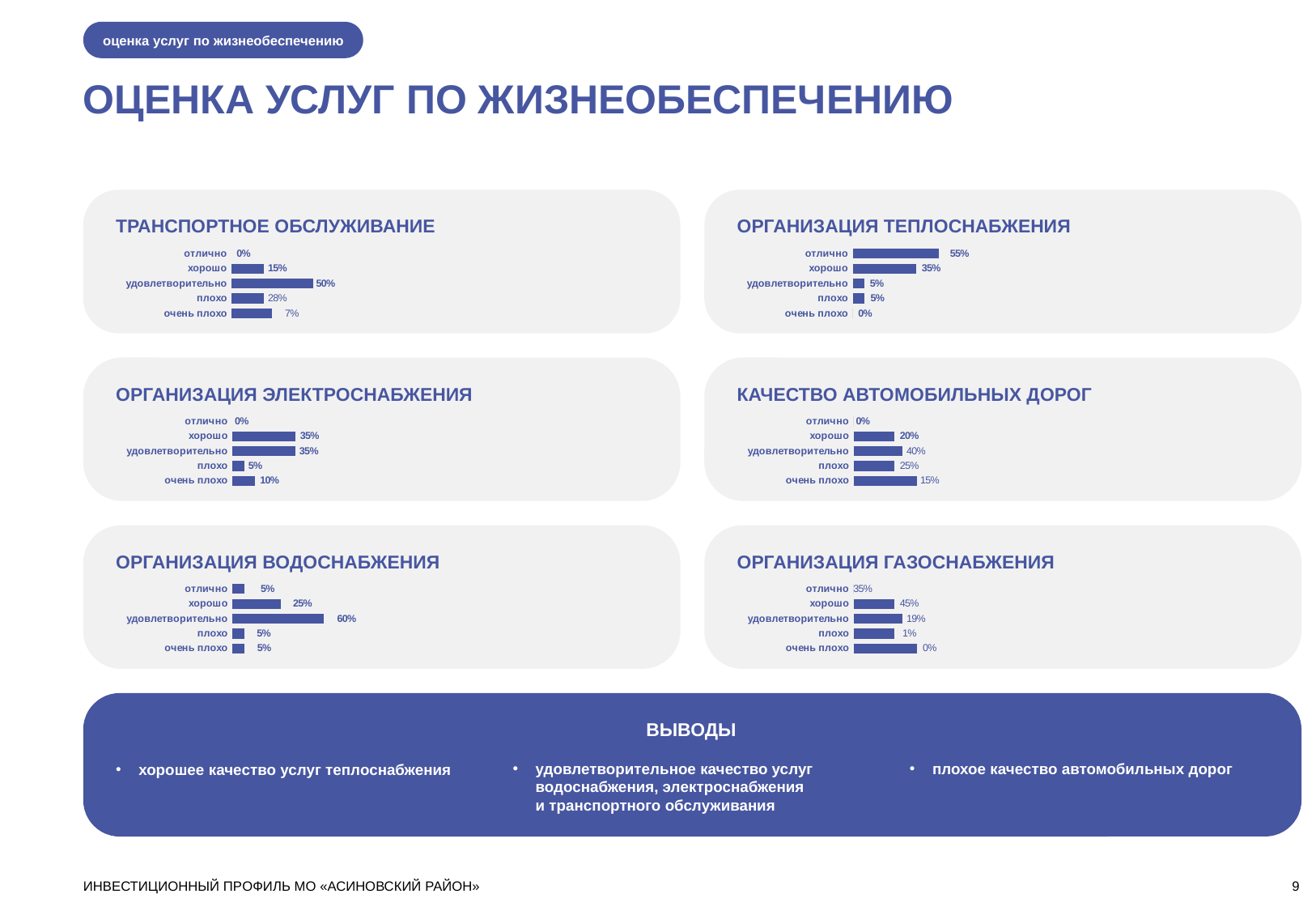
In the 'КАЧЕСТВО АВТОМОБИЛЬНЫХ ДОРОГ' chart, what is the value for 'удовлетворительно'? 40% In the 'ОРГАНИЗАЦИЯ ТЕПЛОСНАБЖЕНИЯ' chart, what is the difference between 'отлично' and 'хорошо'? 20% In the 'ТРАНСПОРТНОЕ ОБСЛУЖИВАНИЕ' chart, what is the value for 'удовлетворительно'? 50% In the 'ОРГАНИЗАЦИЯ ВОДОСНАБЖЕНИЯ' chart, which category has the highest value? удовлетворительно How many categories does the 'ТРАНСПОРТНОЕ ОБСЛУЖИВАНИЕ' chart show? 5 What type of chart is used in the 'ОРГАНИЗАЦИЯ ТЕПЛОСНАБЖЕНИЯ' panel? Bar chart In the 'ТРАНСПОРТНОЕ ОБСЛУЖИВАНИЕ' chart, what is the value for 'плохо'? 28% In the 'КАЧЕСТВО АВТОМОБИЛЬНЫХ ДОРОГ' chart, what is the difference between 'плохо' and 'очень плохо'? 10% In the 'ОРГАНИЗАЦИЯ ЭЛЕКТРОСНАБЖЕНИЯ' chart, which is larger: 'плохо' or 'очень плохо'? очень плохо In the 'ОРГАНИЗАЦИЯ ТЕПЛОСНАБЖЕНИЯ' chart, which category has the highest value? отлично In the 'ОРГАНИЗАЦИЯ ВОДОСНАБЖЕНИЯ' chart, what is the value for 'хорошо'? 25% In the 'ОРГАНИЗАЦИЯ ЭЛЕКТРОСНАБЖЕНИЯ' chart, what is the value for 'очень плохо'? 10%